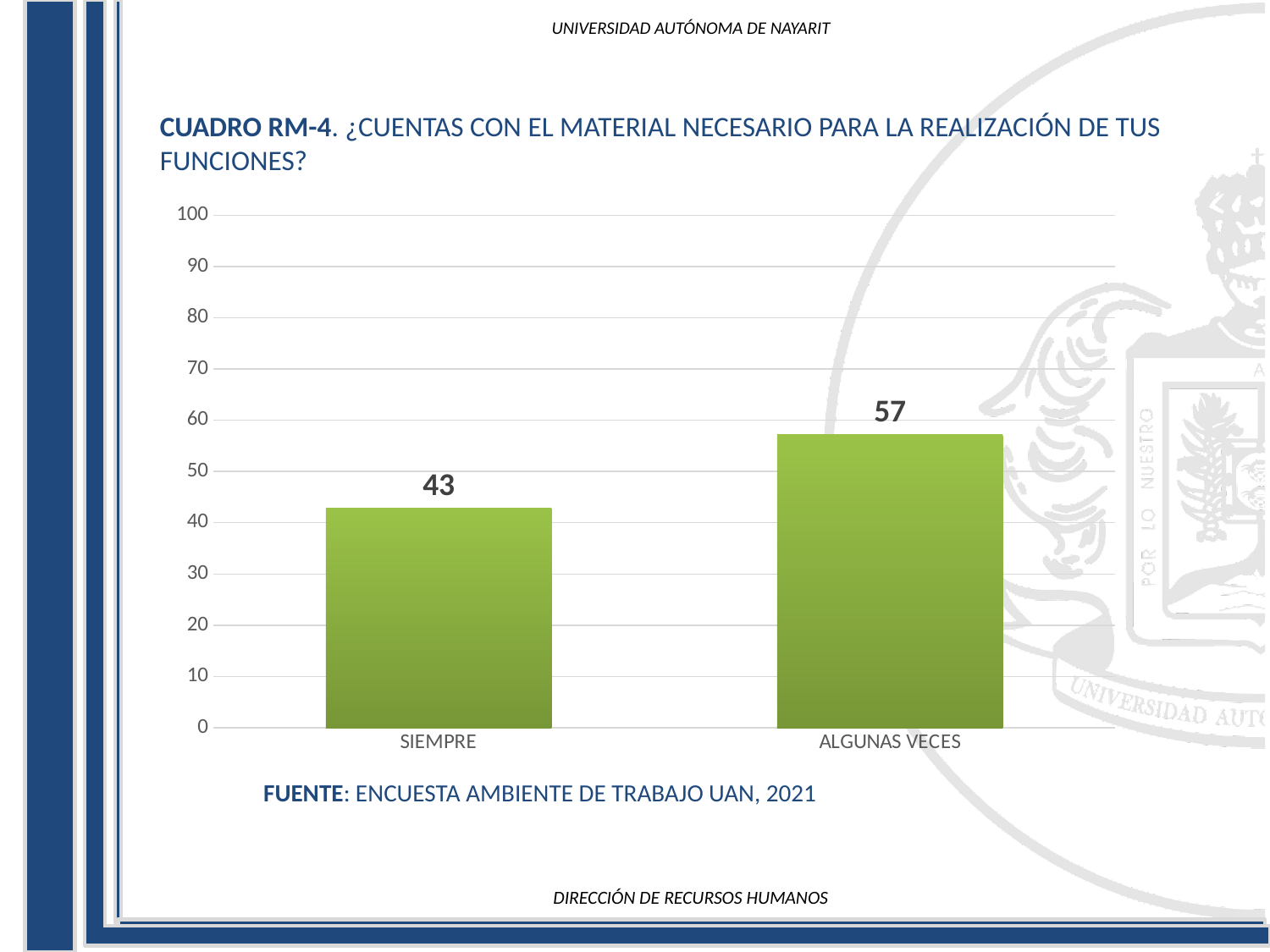
What kind of chart is shown on the slide? bar chart What is the maximum value shown on the vertical axis? 100 What is the value for SIEMPRE? 43 Which category has the lowest value? SIEMPRE What is the total of the two values shown in the chart? 100 Is the value for ALGUNAS VECES greater or less than 50? greater Which category has the highest value? ALGUNAS VECES Which is larger, the value for SIEMPRE or the value for ALGUNAS VECES? ALGUNAS VECES How many categories are shown on the x axis? 2 Is the value for SIEMPRE greater or less than 50? less What is the value for ALGUNAS VECES? 57 What is the difference between the values for ALGUNAS VECES and SIEMPRE? 14